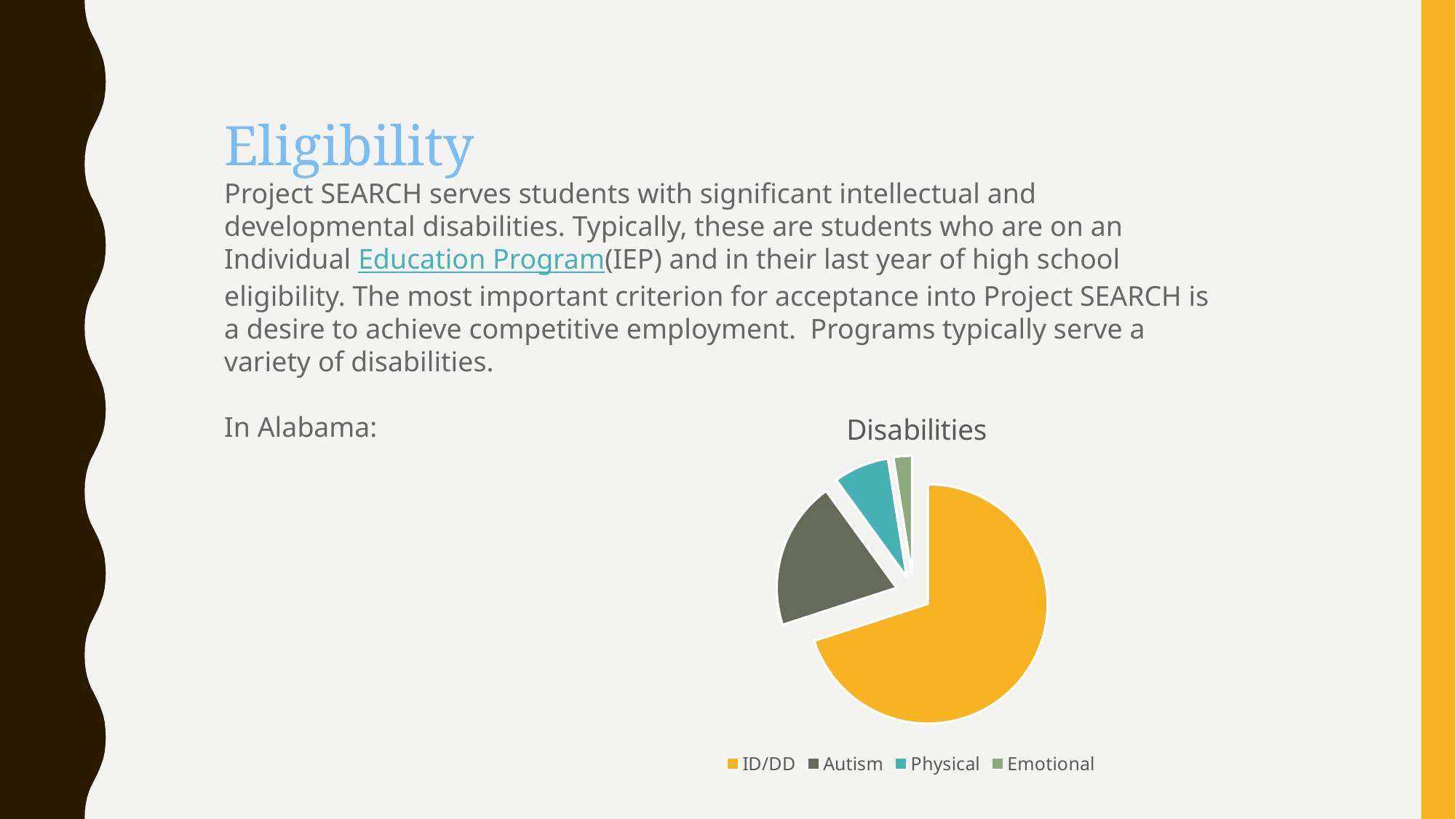
Which slice is larger, ID/DD or Autism? ID/DD Which category has the smallest slice of the pie? Emotional What is the title of the chart? Disabilities Which slice is larger, Autism or Physical? Autism How many categories does the pie chart show? 4 Which slice is larger, Physical or Emotional? Physical What kind of chart is shown on the slide? pie chart Which category has the largest slice of the pie? ID/DD Which category is the second largest slice of the pie? Autism Which category is shown in yellow/orange in the pie chart? ID/DD